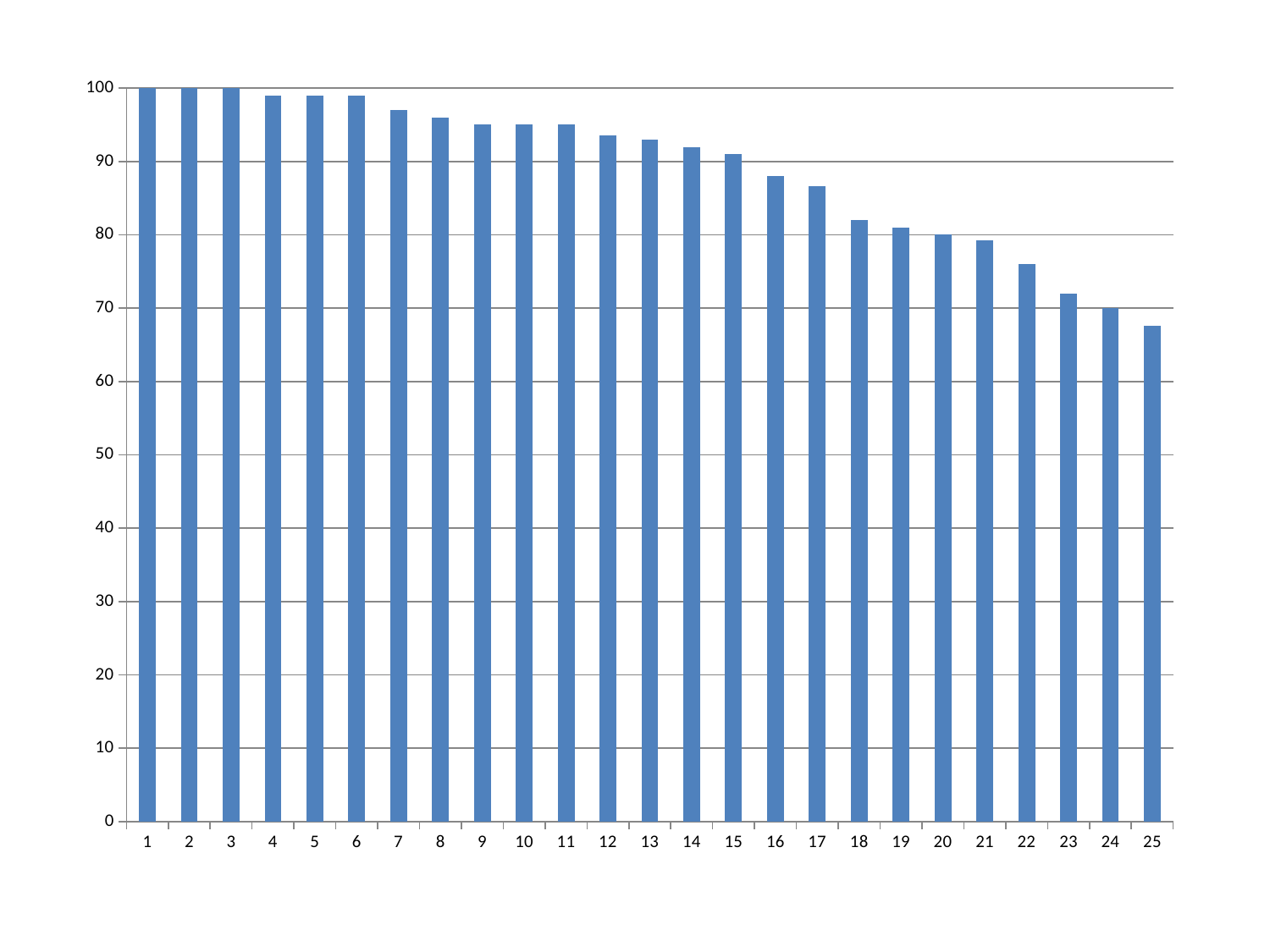
Is the value for category 13 greater or less than 90? greater Which is larger, the value for category 18 or the value for category 10? category 10 What kind of chart is shown on the slide? bar chart Is the value for category 16 greater or less than 90? less Is the value for category 22 greater or less than 80? less Do the values generally rise or fall as the category number increases from 1 to 25? fall Which category has the lowest value? 25 How many bars are plotted on the chart? 25 Which is larger, the value for category 5 or the value for category 22? category 5 What is the value for category 1? 100 What is the value for category 24? 70